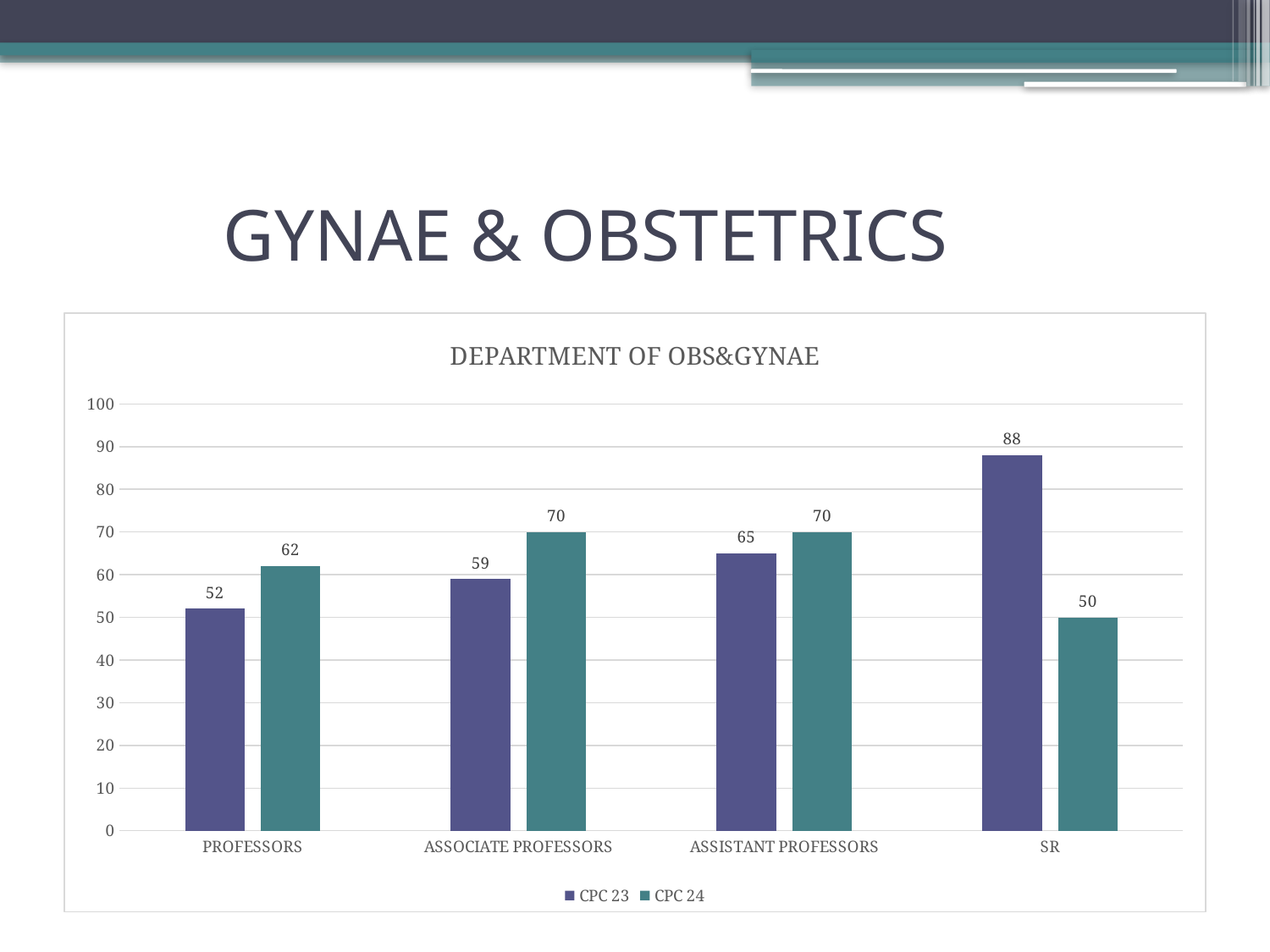
What is the difference between the CPC 24 and CPC 23 values for PROFESSORS? 10 What is the difference between the CPC 23 and CPC 24 values for SR? 38 What is the CPC 23 value for PROFESSORS? 52 Which category has the lowest CPC 24 value? SR What is the title of the chart? DEPARTMENT OF OBS&GYNAE How many categories are shown on the x axis? 4 Is the CPC 23 value for SR greater or less than 80? greater What is the CPC 24 value for SR? 50 Which is larger for ASSISTANT PROFESSORS, CPC 23 or CPC 24? CPC 24 Which category has the highest CPC 23 value? SR How many series does the legend list? 2 What is the CPC 24 value for ASSOCIATE PROFESSORS? 70